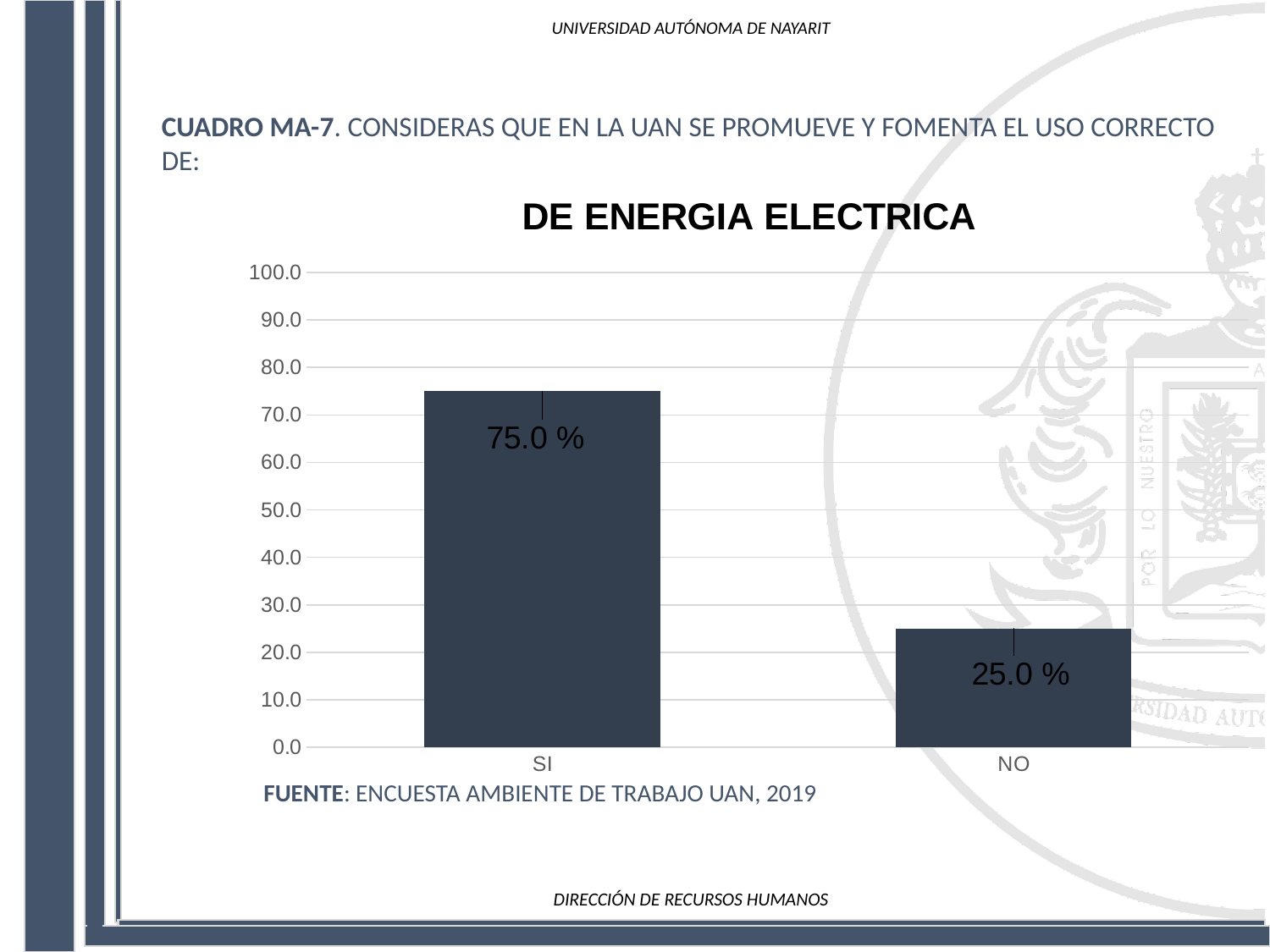
Is the value for NO greater or less than 30.0? less What is the value for NO? 25.0 % What is the highest value shown on the y axis? 100.0 What is the title of the chart? DE ENERGIA ELECTRICA What is the difference between the values for SI and NO? 50.0 % What kind of chart is shown on the slide? bar chart Which category has the highest value? SI How many categories are shown on the x axis? 2 Which is larger, the value for SI or the value for NO? SI What is the value for SI? 75.0 % Which category has the lowest value? NO Is the value for SI greater or less than 70.0? greater